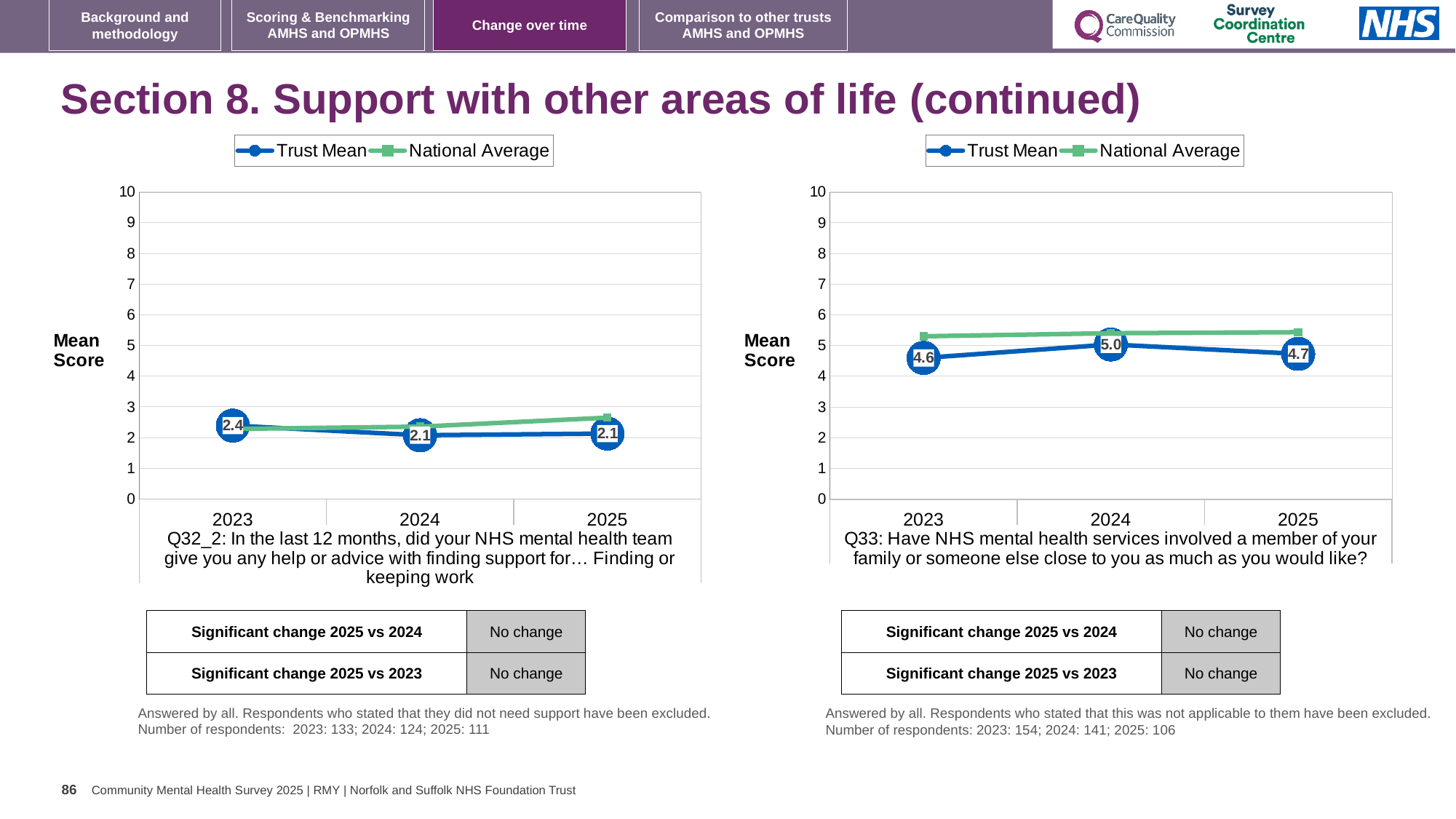
In the left chart (Q32_2), is the National Average for 2025 greater or less than 3? less What kind of chart is the left chart (Q32_2)? Line chart In the right chart (Q33), what is the difference between the Trust Mean for 2024 and the Trust Mean for 2023? 0.4 In the left chart (Q32_2), what is the Trust Mean for 2025? 2.1 In the right chart (Q33), which year has the lowest Trust Mean? 2023 In the right chart (Q33), which year has the highest Trust Mean? 2024 In the right chart (Q33), what is the Trust Mean for 2025? 4.7 In the right chart (Q33), is the National Average for 2025 greater or less than 5? greater How many series does the legend of the right chart (Q33) list? 2 In the left chart (Q32_2), what is the difference between the Trust Mean for 2023 and the Trust Mean for 2024? 0.3 In the left chart (Q32_2), what is the Trust Mean for 2023? 2.4 In the right chart (Q33), what is the Trust Mean for 2024? 5.0